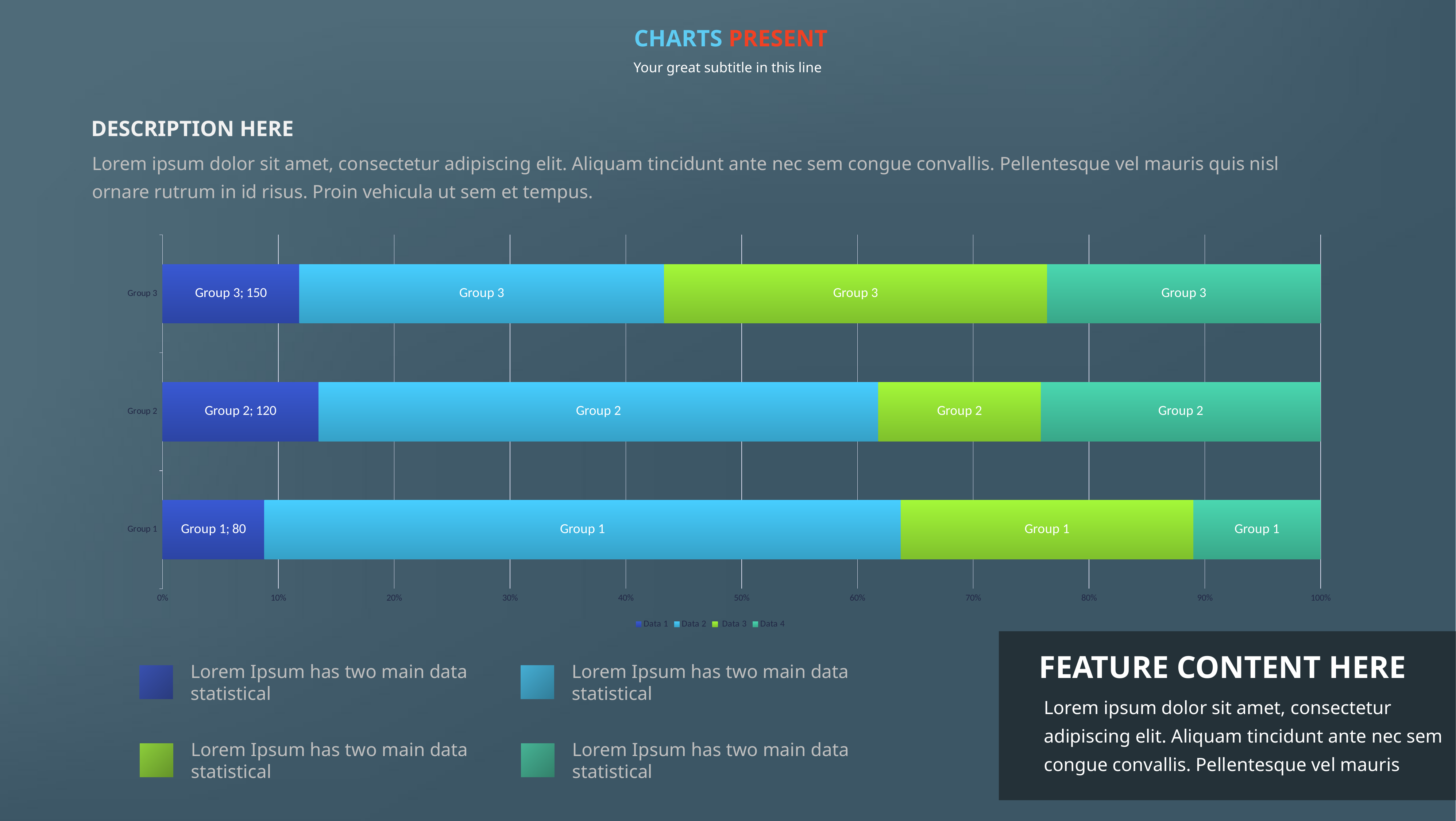
What is the Data 1 value labelled for Group 1? 80 What is the Data 1 value labelled for Group 2? 120 Which group has the highest labelled Data 1 value? Group 3 How many groups (categories) are plotted on the chart? 3 How many series does the chart legend list? 4 What is the difference between the Data 1 values of Group 3 and Group 1? 70 What kind of chart is shown on the slide? bar chart What is the Data 1 value labelled for Group 3? 150 What are the four series names listed in the legend? Data 1, Data 2, Data 3, Data 4 Is the share of the Group 1 bar taken by Data 2 greater or less than 50%? greater Which group has the lowest labelled Data 1 value? Group 1 Which has the larger Data 1 value, Group 2 or Group 1? Group 2